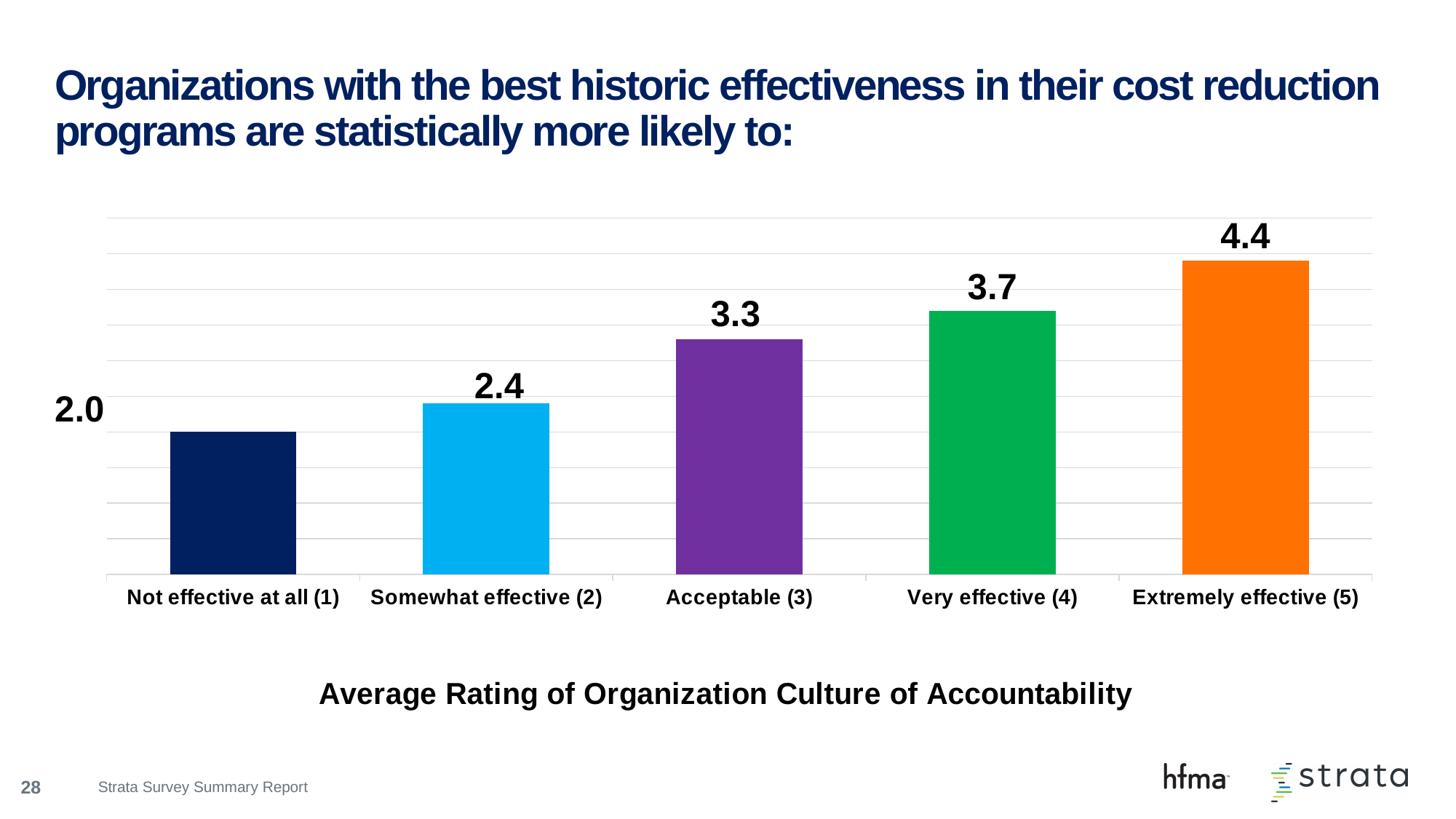
What is the difference between the values for Very effective (4) and Somewhat effective (2)? 1.3 What kind of chart is shown on the slide? Bar chart What is the difference between the values for Extremely effective (5) and Not effective at all (1)? 2.4 Do the values rise or fall from Not effective at all (1) to Extremely effective (5)? Rise Which category has the highest average rating? Extremely effective (5) Which category has the lowest average rating? Not effective at all (1) Which has a higher value, Acceptable (3) or Somewhat effective (2)? Acceptable (3) What is the value shown for Extremely effective (5)? 4.4 What is the value shown for Not effective at all (1)? 2.0 How many categories are shown on the chart? 5 What is the average rating of organization culture of accountability for Acceptable (3)? 3.3 What is the value shown for Very effective (4)? 3.7